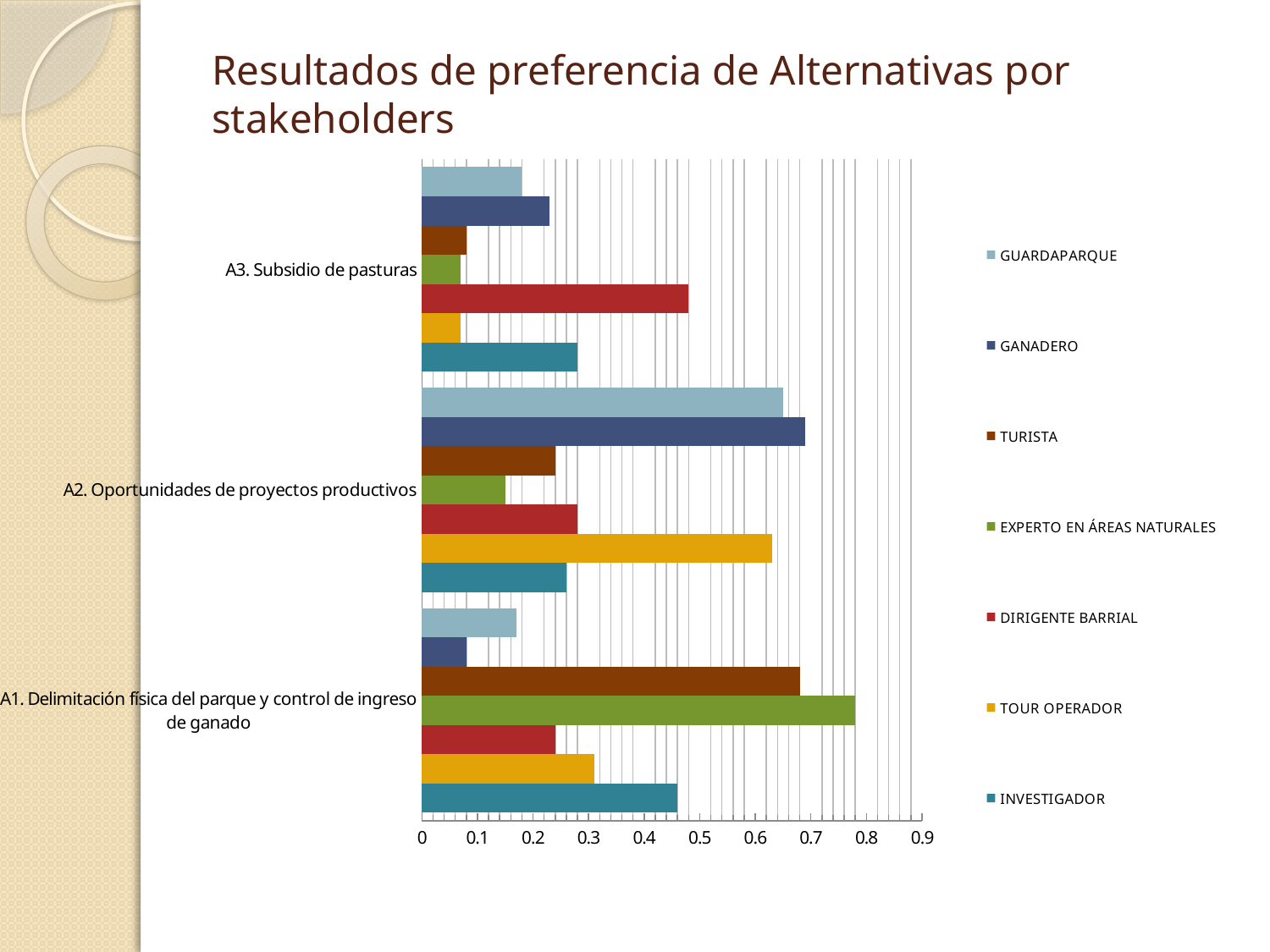
How many alternatives (categories) are plotted on the chart? 3 Is the value for GANADERO on A2. Oportunidades de proyectos productivos greater or less than 0.6? greater Is the value for TURISTA on A3. Subsidio de pasturas greater or less than 0.1? less For which alternative is the TOUR OPERADOR value lowest? A3. Subsidio de pasturas Which legend entry is shown in red? DIRIGENTE BARRIAL What is the title of the slide containing the chart? Resultados de preferencia de Alternativas por stakeholders How many stakeholder series does the legend list? 7 On A1. Delimitación física del parque y control de ingreso de ganado, which is larger: the value for INVESTIGADOR or the value for GANADERO? INVESTIGADOR Is the value for EXPERTO EN ÁREAS NATURALES on A1. Delimitación física del parque y control de ingreso de ganado greater or less than 0.7? greater For which alternative is the EXPERTO EN ÁREAS NATURALES value highest? A1. Delimitación física del parque y control de ingreso de ganado What kind of chart is shown on the slide? bar chart